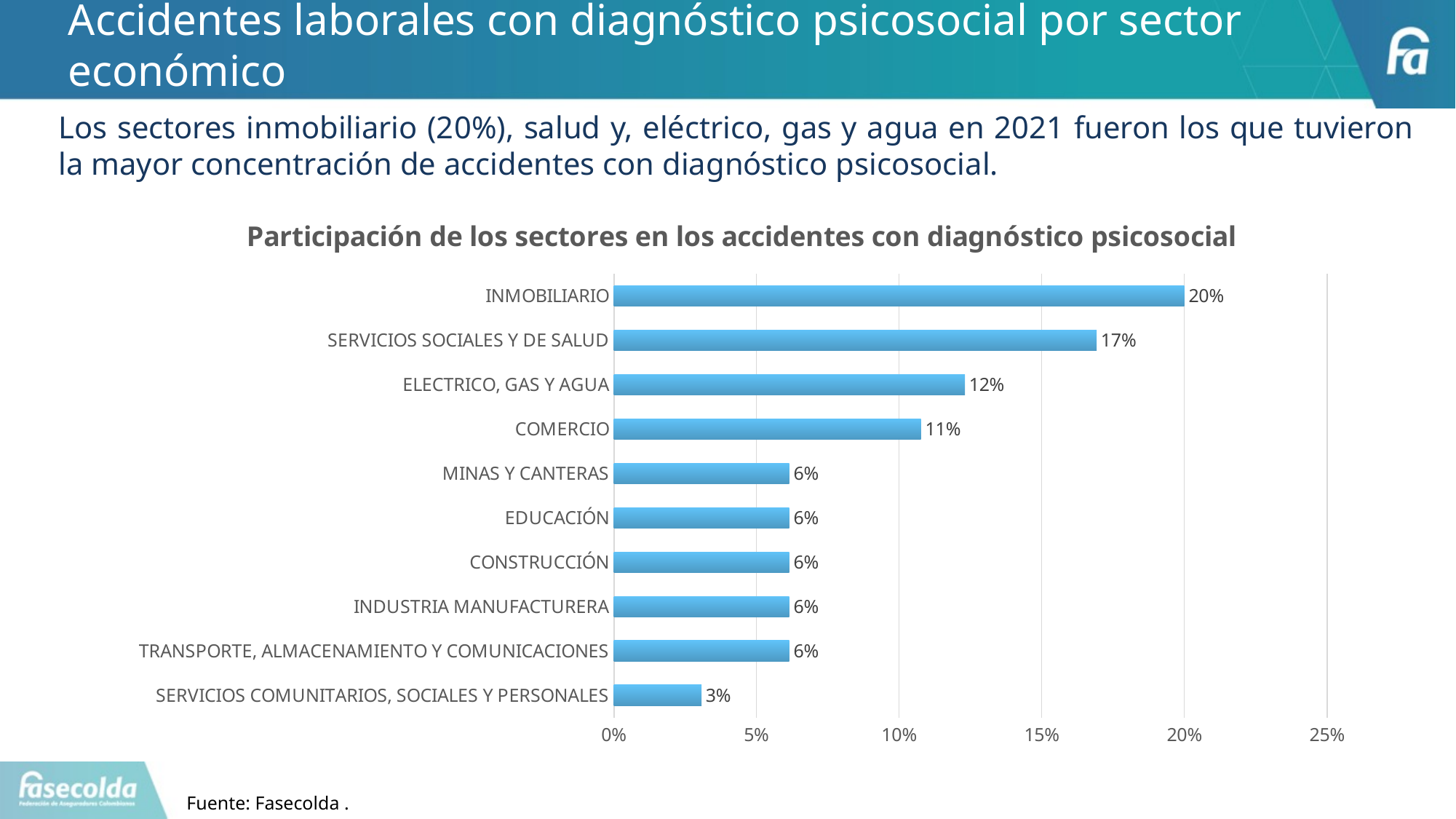
What is the difference between the values for INMOBILIARIO and SERVICIOS SOCIALES Y DE SALUD? 3% How many sectors are shown in the chart? 10 What is the value for COMERCIO? 11% What kind of chart is shown on the slide? Bar chart What is the value for SERVICIOS COMUNITARIOS, SOCIALES Y PERSONALES? 3% Which is larger, the value for ELECTRICO, GAS Y AGUA or the value for COMERCIO? ELECTRICO, GAS Y AGUA What is the value for SERVICIOS SOCIALES Y DE SALUD? 17% What is the title of the chart? Participación de los sectores en los accidentes con diagnóstico psicosocial Which sector has the lowest share? SERVICIOS COMUNITARIOS, SOCIALES Y PERSONALES What is the value for INMOBILIARIO? 20% Which sector has the highest share? INMOBILIARIO Is the value for SERVICIOS SOCIALES Y DE SALUD greater or less than 15%? greater